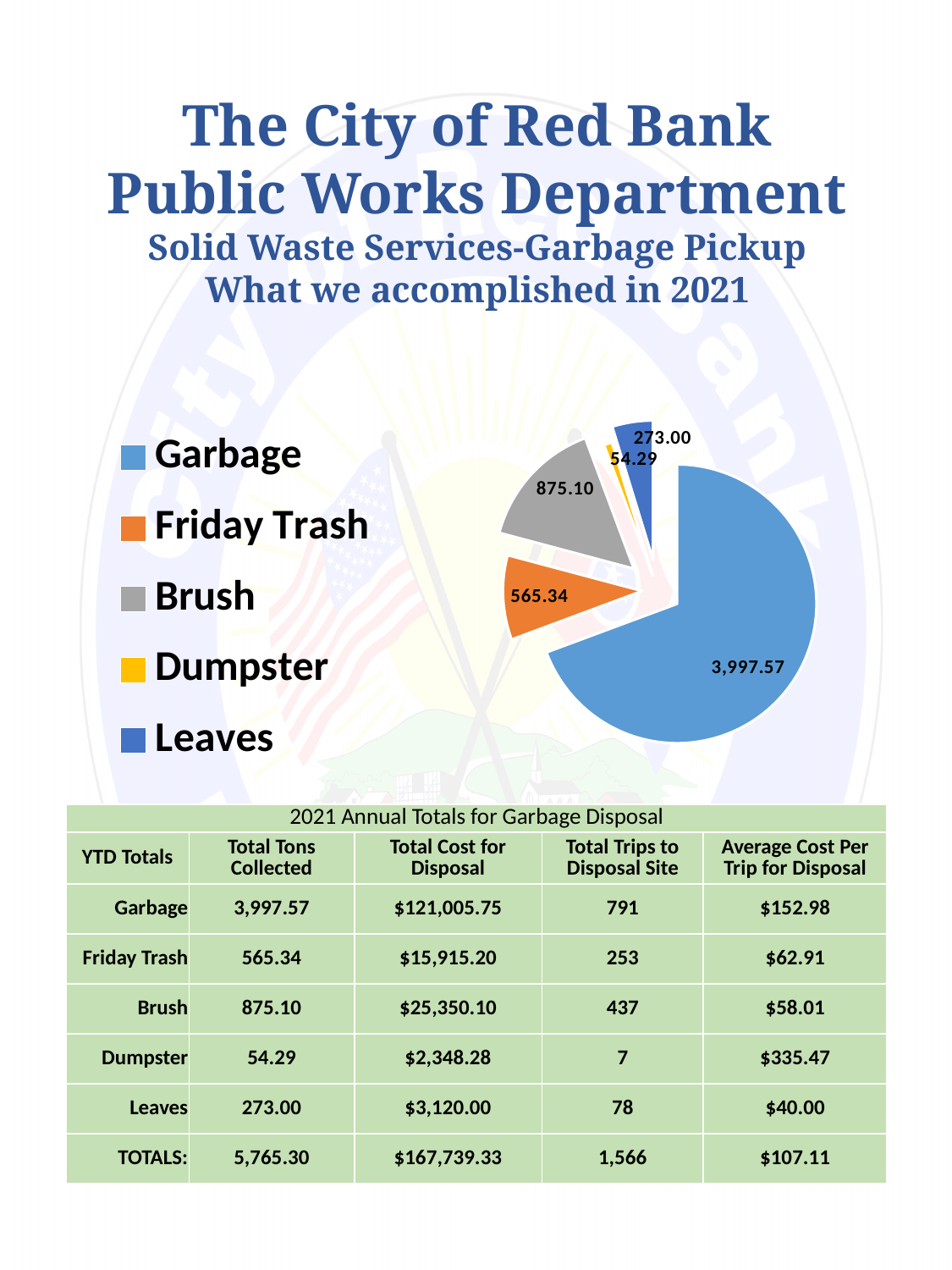
What is the difference between the Leaves and Dumpster values in the pie chart? 218.71 What is the difference between the Brush and Friday Trash values in the pie chart? 309.76 What colour is the Friday Trash slice in the pie chart? orange Which category has the largest slice in the pie chart? Garbage What kind of chart is shown on the slide? pie chart What is the value of the Leaves slice in the pie chart? 273.00 How many slices does the pie chart have? 5 Which category has the smallest slice in the pie chart? Dumpster What is the value of the Garbage slice in the pie chart? 3,997.57 Which slice is larger in the pie chart, Brush or Friday Trash? Brush What is the value of the Dumpster slice in the pie chart? 54.29 What is the value of the Brush slice in the pie chart? 875.10